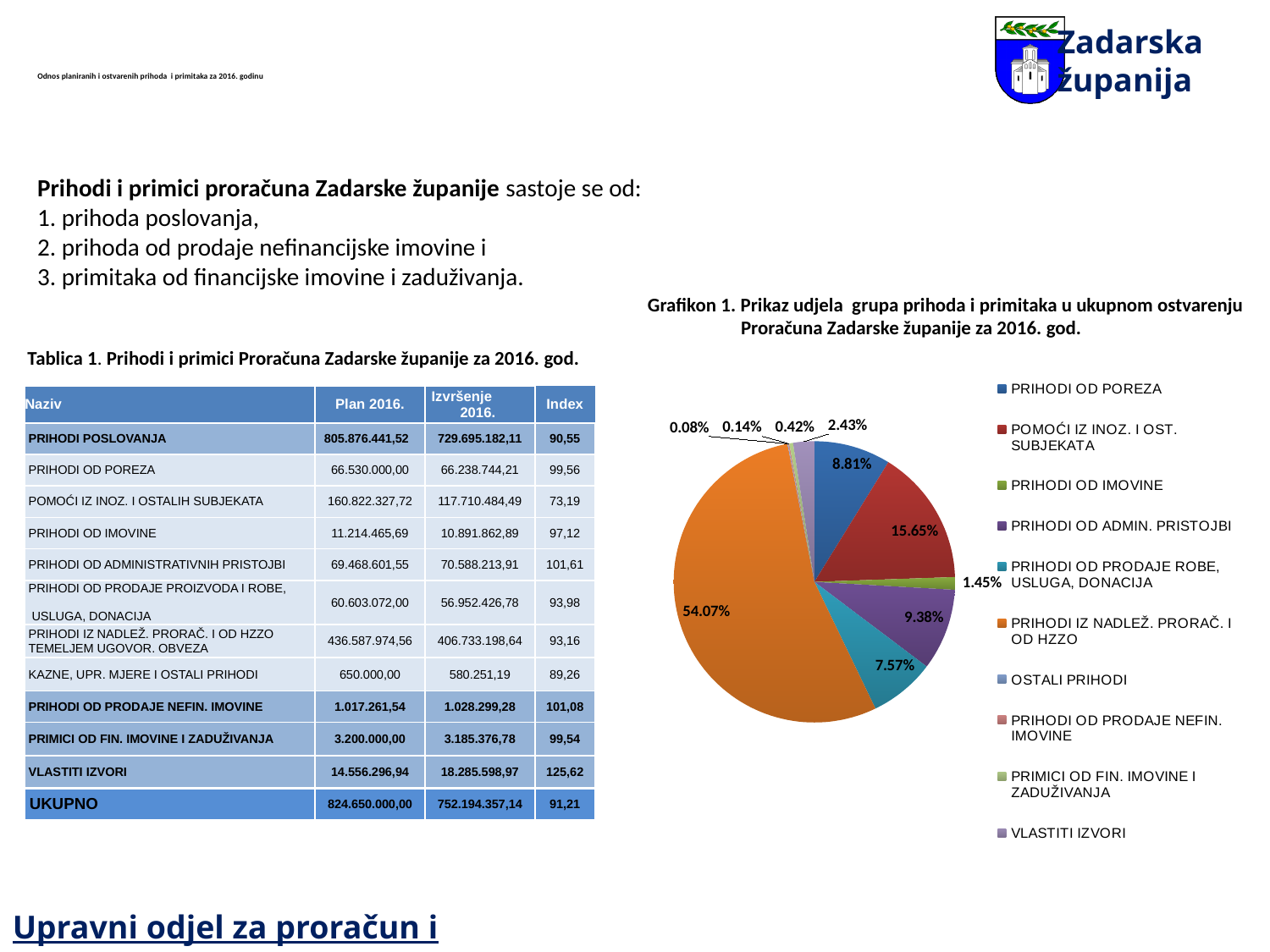
In Grafikon 1, what share does PRIHODI OD POREZA have? 8.81% In Grafikon 1, what is the difference in percentage points between POMOĆI IZ INOZ. I OST. SUBJEKATA and PRIHODI OD POREZA? 6.84 In Grafikon 1, what share does POMOĆI IZ INOZ. I OST. SUBJEKATA have? 15.65% In Grafikon 1, which category has the smallest share? OSTALI PRIHODI In Grafikon 1, which category has the largest share? PRIHODI IZ NADLEŽ. PRORAČ. I OD HZZO In Grafikon 1, what share does PRIHODI OD ADMIN. PRISTOJBI have? 9.38% In Grafikon 1, what share does PRIHODI IZ NADLEŽ. PRORAČ. I OD HZZO have? 54.07% In Grafikon 1, what share does VLASTITI IZVORI have? 2.43% How many categories does the legend of Grafikon 1 list? 10 In Grafikon 1, what colour is the slice for PRIHODI IZ NADLEŽ. PRORAČ. I OD HZZO? orange What type of chart is Grafikon 1? pie chart In Grafikon 1, which is larger: PRIHODI OD ADMIN. PRISTOJBI or PRIHODI OD PRODAJE ROBE, USLUGA, DONACIJA? PRIHODI OD ADMIN. PRISTOJBI